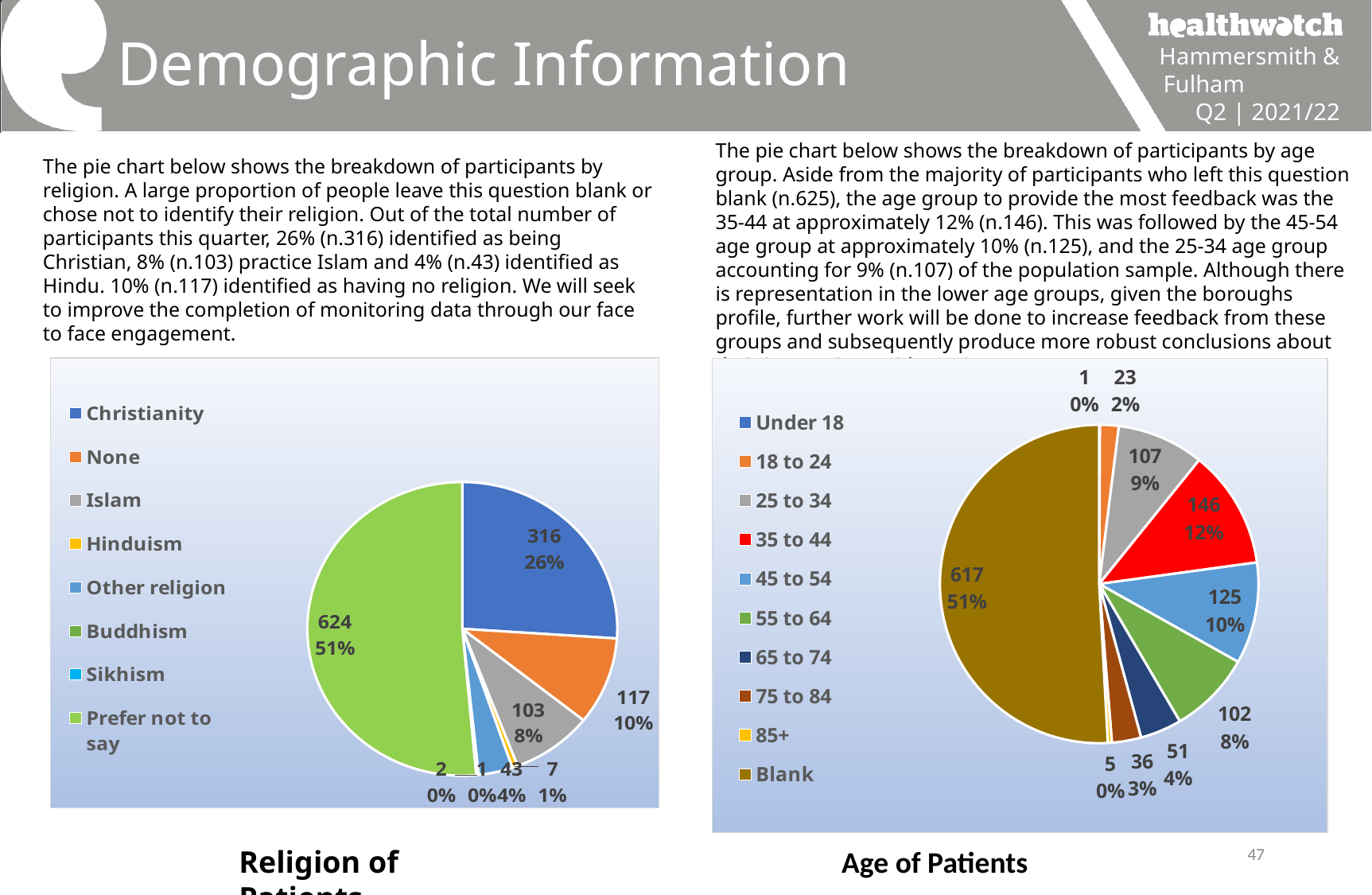
In the Religion of Patients pie chart, what percentage share does Prefer not to say have? 51% In the Religion of Patients pie chart, which category has the largest slice? Prefer not to say In the Religion of Patients pie chart, which is larger, None or Islam? None In the Age of Patients pie chart, which category has the largest slice? Blank In the Age of Patients pie chart, what percentage share does the 45 to 54 age group have? 10% In the Religion of Patients pie chart, how many participants identified as Christianity? 316 What type of chart is the Age of Patients chart? Pie chart How many categories does the legend of the Age of Patients pie chart list? 10 How many entries does the legend of the Religion of Patients pie chart list? 8 In the Age of Patients pie chart, what is the difference between the 35 to 44 count and the 25 to 34 count? 39 In the Age of Patients pie chart, how many participants were in the 35 to 44 age group? 146 In the Religion of Patients pie chart, what is the difference between the Christianity count and the Islam count? 213